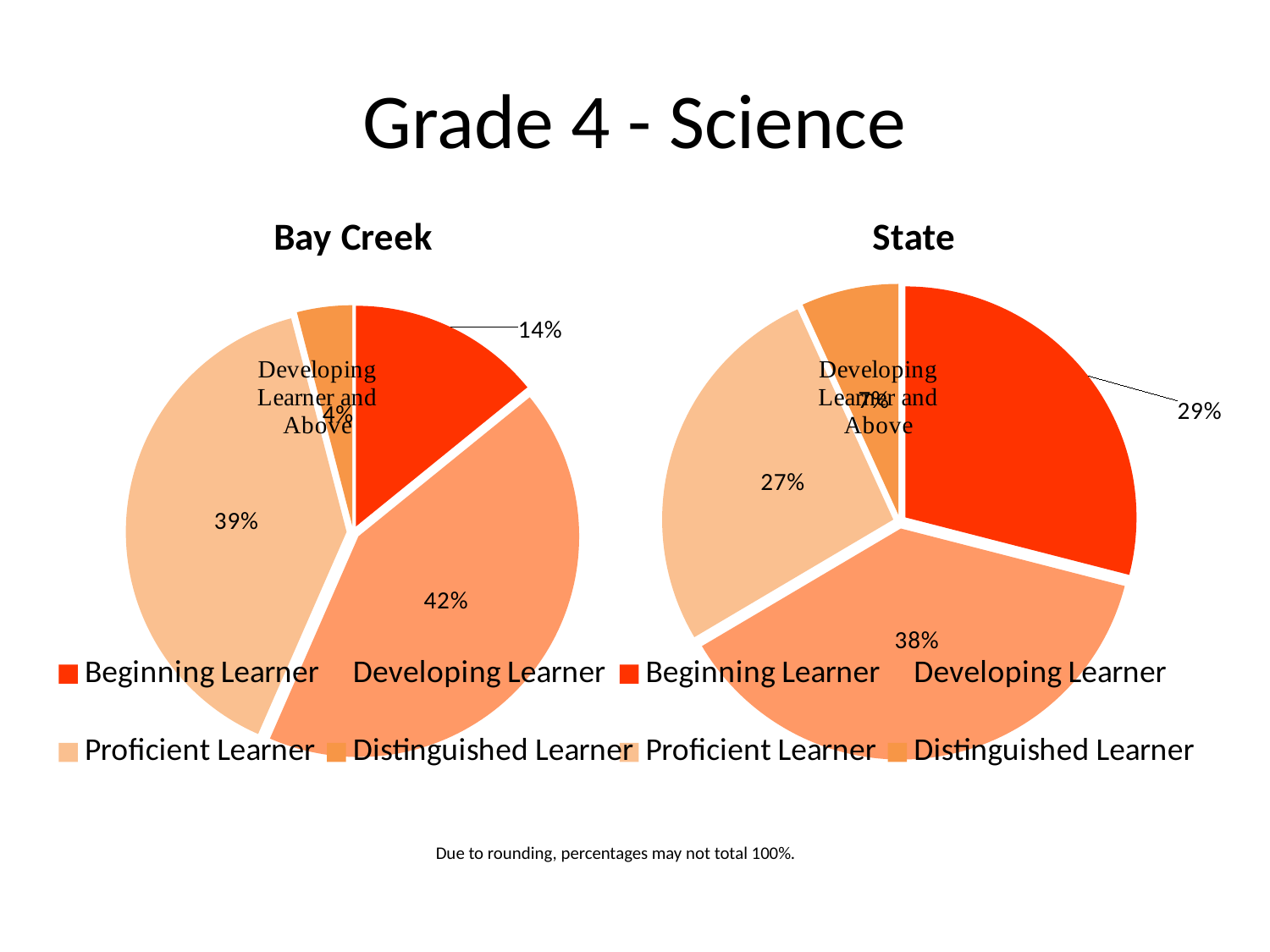
In the Bay Creek chart, what percentage is shown for the Developing Learner slice? 42% How many categories does the legend of the State chart list? 4 In the State chart, what percentage is shown for the Proficient Learner slice? 27% In the Bay Creek chart, what percentage is shown for the Beginning Learner slice? 14% Which is larger: the Proficient Learner share in the Bay Creek chart or in the State chart? Bay Creek What is the title of the slide? Grade 4 - Science What is the difference between the Beginning Learner percentages in the State chart and the Bay Creek chart? 15% In the State chart, what percentage is shown for the Beginning Learner slice? 29% What type of chart is used for Bay Creek? Pie chart In the Bay Creek chart, which category has the smallest slice? Distinguished Learner In the State chart, which category has the largest slice? Developing Learner In the Bay Creek chart, which category has the largest slice? Developing Learner